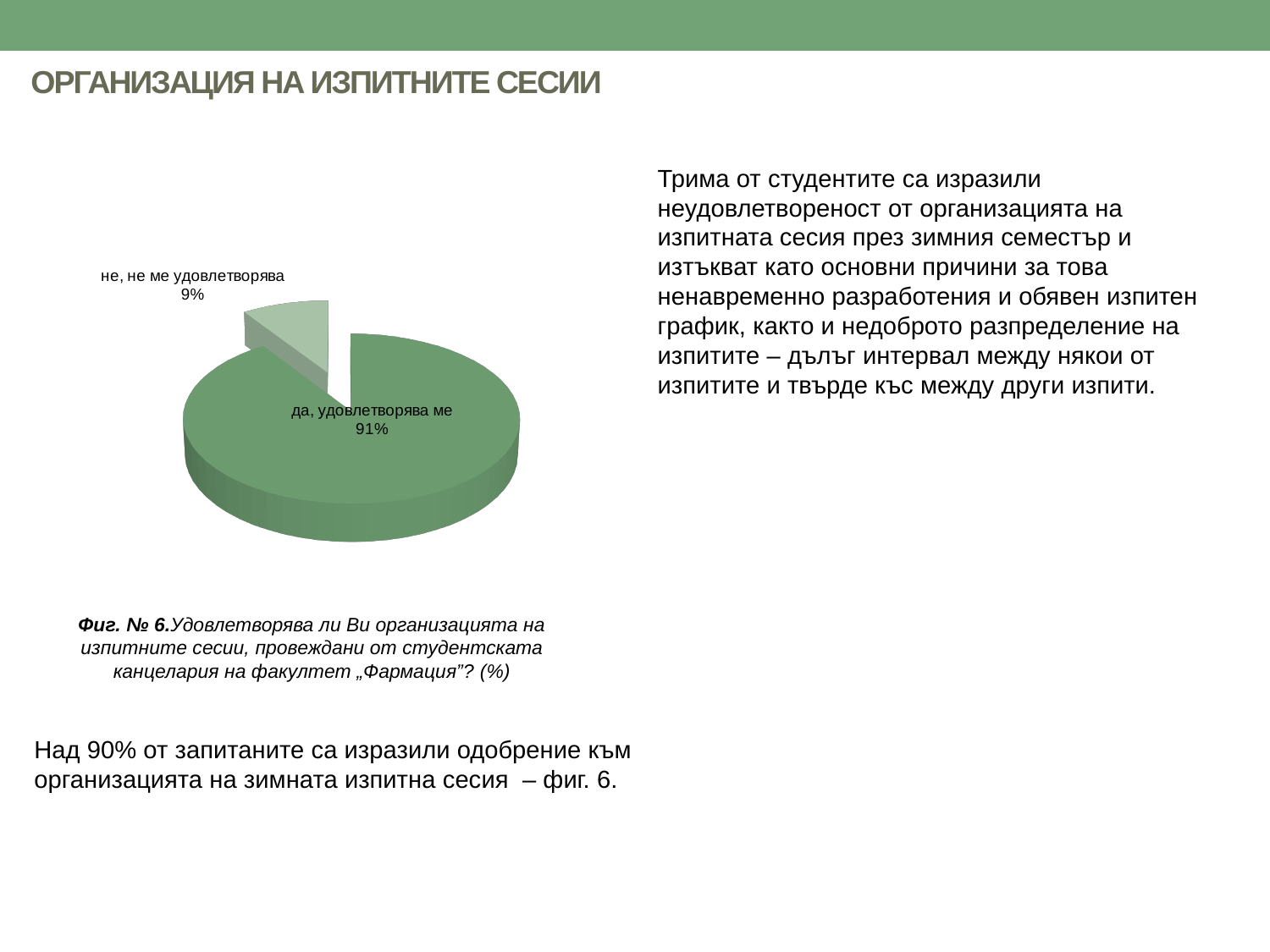
Which slice of the pie chart is the largest? да, удовлетворява ме How many slices does the pie chart have? 2 What percentage is shown for "не, не ме удовлетворява"? 9% What kind of chart is shown on the slide? pie chart What share of the pie does the "не, не ме удовлетворява" slice represent? 9% What is the difference in percentage points between "да, удовлетворява ме" and "не, не ме удовлетворява"? 82 Which slice of the pie chart is the smallest? не, не ме удовлетворява Which is larger: the share for "да, удовлетворява ме" or for "не, не ме удовлетворява"? да, удовлетворява ме What percentage is shown for "да, удовлетворява ме"? 91% What is the figure number given in the caption of the chart? Фиг. № 6 Is the "не, не ме удовлетворява" slice pulled out (exploded) from the rest of the pie? yes